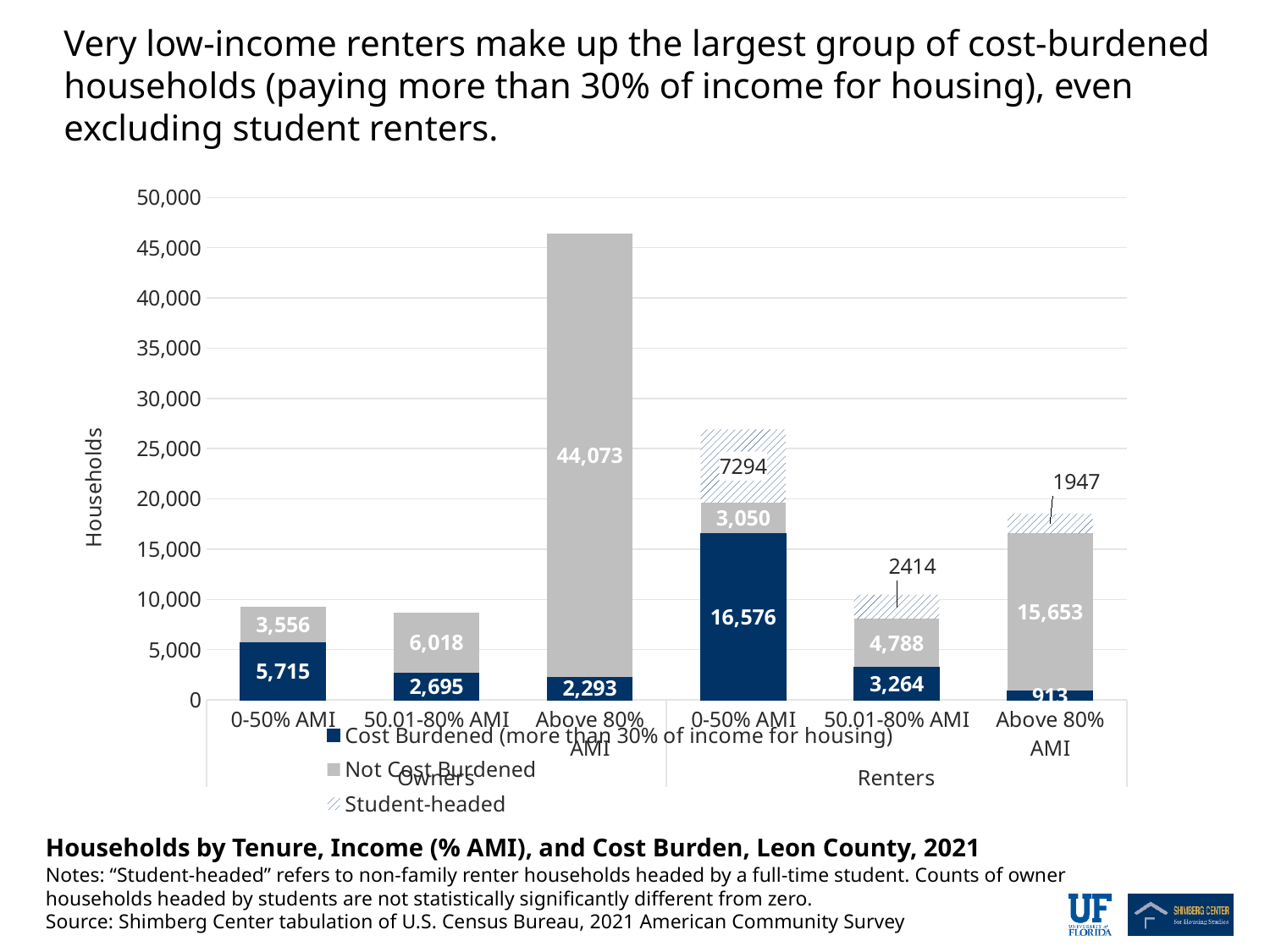
Is the total height of the Owners Above 80% AMI bar greater or less than 40,000? greater What kind of chart is shown on the slide? Stacked bar chart How many income-group bars are shown in the chart? 6 What is the difference between cost-burdened owner households in the 0-50% AMI group and the 50.01-80% AMI group? 3,020 How many series does the legend list? 3 What is the total number of renter households in the 0-50% AMI group (cost burdened, not cost burdened, and student-headed combined)? 26,920 Which is larger: the number of cost-burdened renters in the 0-50% AMI group or the number of not-cost-burdened renters in the Above 80% AMI group? Cost-burdened renters in the 0-50% AMI group Which income group has the highest number of cost-burdened households? Renters, 0-50% AMI How many student-headed renter households are in the 50.01-80% AMI group? 2414 What is the number of not-cost-burdened owner households in the Above 80% AMI group? 44,073 Which income group has the lowest number of cost-burdened households? Renters, Above 80% AMI What is the number of cost-burdened renter households in the 0-50% AMI group? 16,576